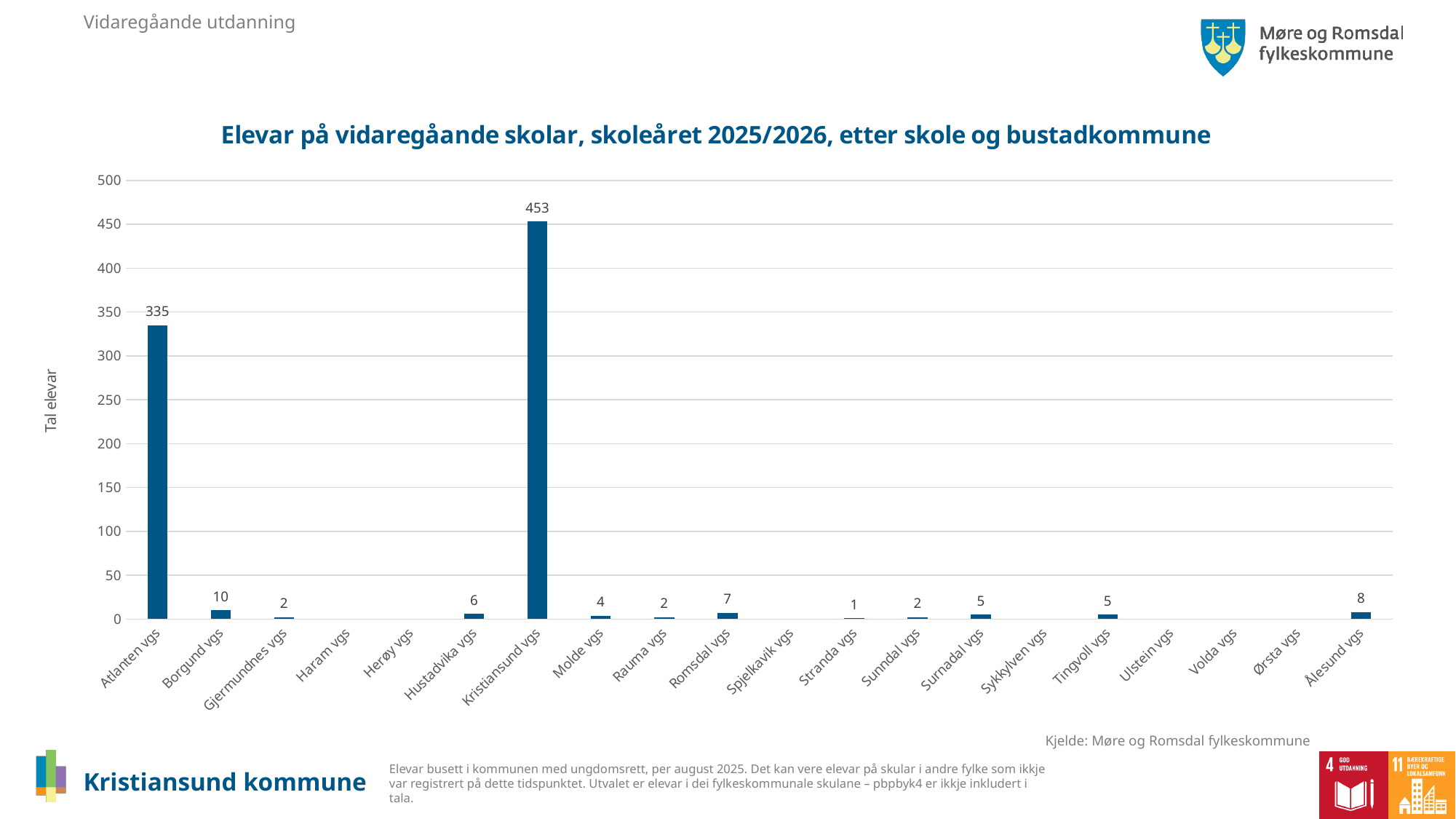
What is the difference between the values for Kristiansund vgs and Atlanten vgs? 118 What is the title of the chart? Elevar på vidaregåande skolar, skoleåret 2025/2026, etter skole og bustadkommune What is the value for Borgund vgs? 10 Which is larger, the value for Romsdal vgs or the value for Hustadvika vgs? Romsdal vgs What is the label of the y axis? Tal elevar How many schools are shown on the x axis? 20 What kind of chart is shown on the slide? Bar chart Is the value for Atlanten vgs greater or less than 300? greater What is the value for Ålesund vgs? 8 What is the value for Atlanten vgs? 335 What is the value for Kristiansund vgs? 453 Which school has the highest number of pupils? Kristiansund vgs